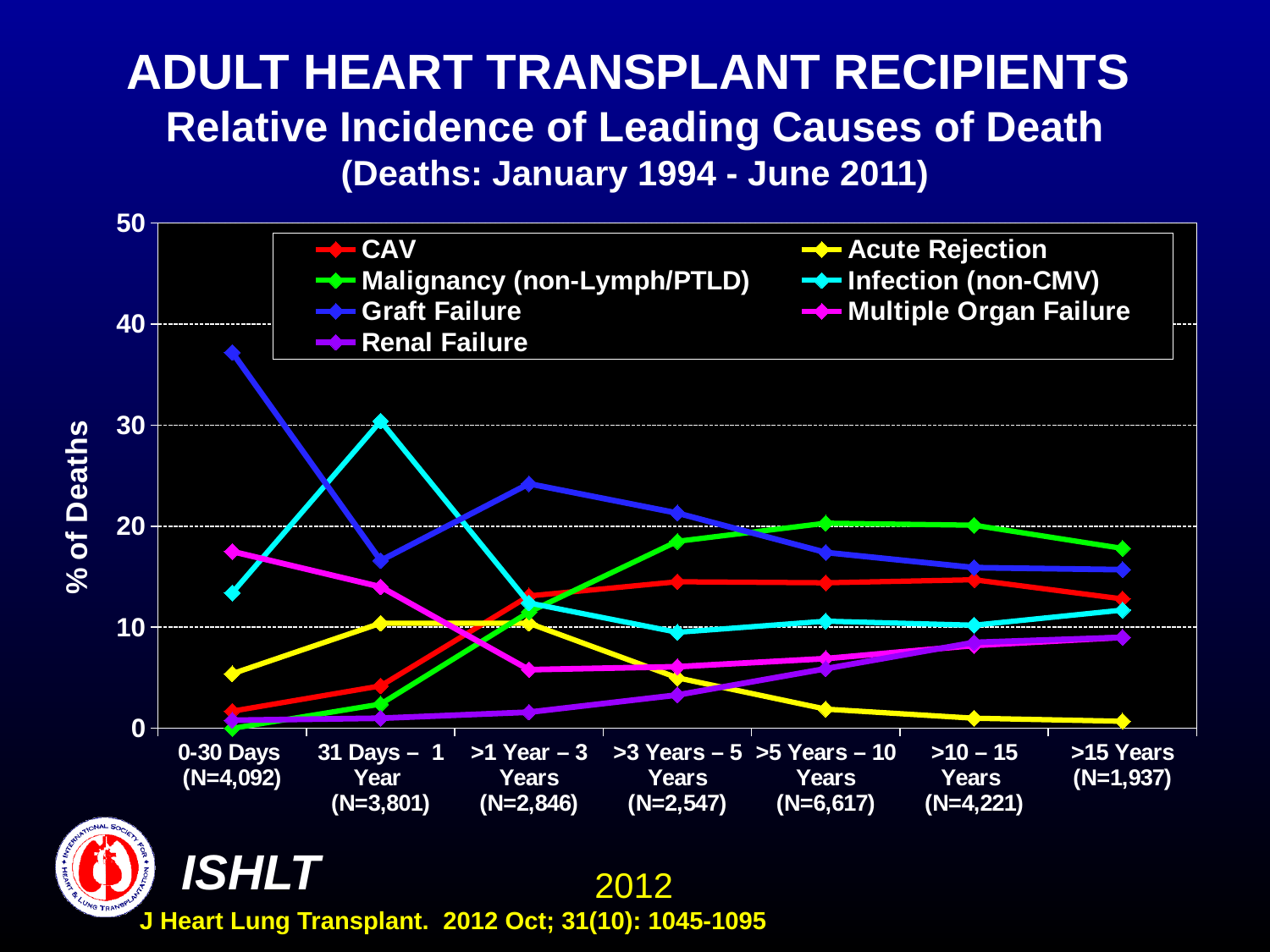
What kind of chart is shown on the slide? line chart Which cause of death has the highest % of deaths in the >15 Years period? Malignancy (non-Lymph/PTLD) In the >5 Years – 10 Years period, which is larger: Malignancy (non-Lymph/PTLD) or CAV? Malignancy (non-Lymph/PTLD) Is the value for Graft Failure in the 0-30 Days period greater or less than 30? greater Does the Renal Failure line rise or fall across the time periods from 0-30 Days to >15 Years? rises Which cause of death has the highest % of deaths in the 31 Days – 1 Year period? Infection (non-CMV) Is the value for Infection (non-CMV) in the 31 Days – 1 Year period greater or less than 20? greater What is the label on the y axis? % of Deaths Which cause of death has the highest % of deaths in the 0-30 Days period? Graft Failure Is the value for Graft Failure in the >1 Year – 3 Years period greater or less than 20? greater How many time-period categories are shown on the x axis? 7 How many series does the legend list? 7